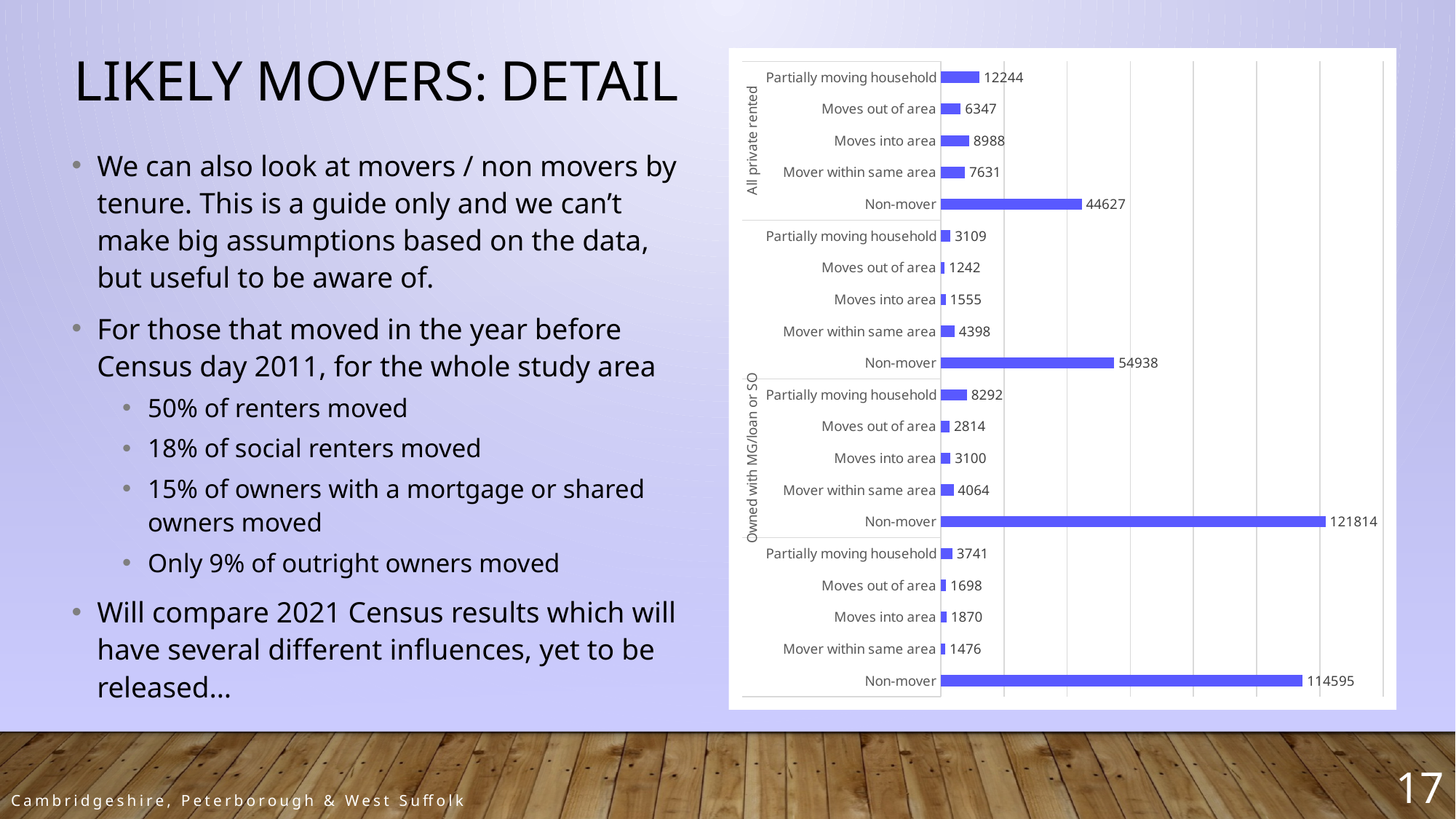
What is the value for Non-mover in the All private rented group? 44627 What is the total of the five values in the All private rented group? 79837 What type of chart is shown on the slide? bar chart In the All private rented group, what is the difference between Non-mover and Partially moving household? 32383 What is the value for Mover within same area in the All private rented group? 7631 What is the value for Non-mover in the Owned with MG/loan or SO group? 121814 What is the value of the bottom-most bar on the chart (Non-mover)? 114595 How many bars are plotted on the chart in total? 20 What is the smallest value shown on the chart? 1242 Which bar has the highest value on the chart? Non-mover in Owned with MG/loan or SO (121814) In the Owned with MG/loan or SO group, what is the difference between Partially moving household and Mover within same area? 4228 In the All private rented group, which is larger: Moves into area or Moves out of area? Moves into area